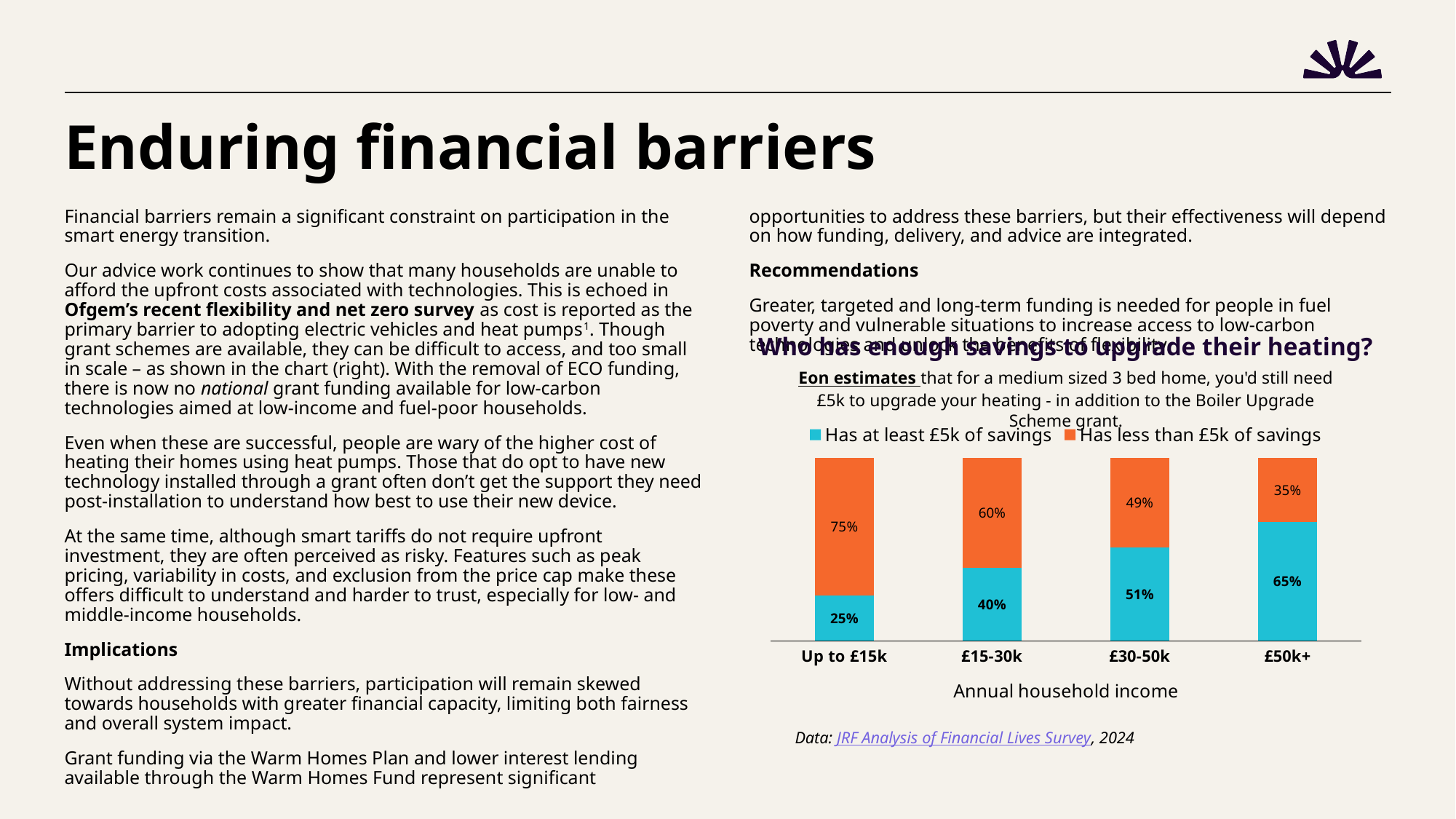
What share of households in the £30-50k income band has at least £5k of savings? 51% Which income band has the lowest share of households with at least £5k of savings? Up to £15k Which income band has the highest share of households with at least £5k of savings? £50k+ What share of households with annual income of £50k+ has less than £5k of savings? 35% How many income bands are shown on the x axis of the chart? 4 As annual household income increases along the x axis, does the share of households with at least £5k of savings rise or fall? Rise In the £15-30k income band, which is larger: the share with at least £5k of savings or the share with less than £5k of savings? Has less than £5k of savings What is the label of the x axis on the chart? Annual household income What kind of chart is used to show who has enough savings to upgrade their heating? Stacked bar chart What is the difference between the share of £50k+ households and the share of up to £15k households that have at least £5k of savings? 40 percentage points What share of households with annual income up to £15k has at least £5k of savings? 25% How many series does the chart legend list? 2